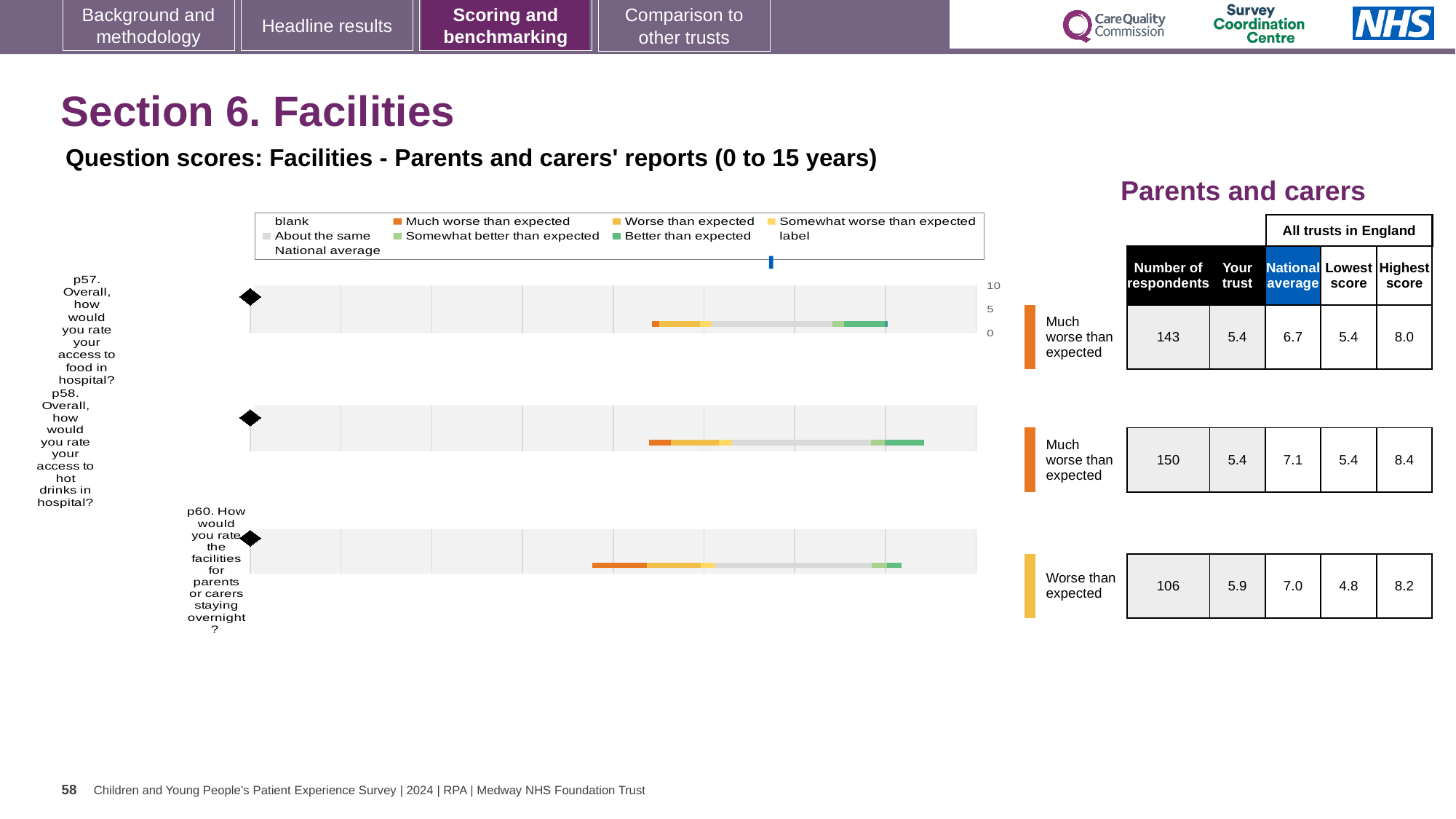
For the p57 chart (access to food in hospital), what is the 'Your trust' score shown in the table? 5.4 For the p58 chart (access to hot drinks in hospital), what is the national average shown in the table? 7.1 Is the 'Your trust' score for p57 (access to food in hospital) larger or smaller than the national average? smaller What is the highest value shown on the axis of the bar charts? 10 What kind of chart is used to show the question scores on this slide? bar chart What is the difference between the national average and the 'Your trust' score for p58 (access to hot drinks in hospital)? 1.7 What benchmark category is assigned to the p60 chart (facilities for parents or carers staying overnight)? Worse than expected Which legend entry is shown in orange in the bar charts' legend? Much worse than expected Which of the three questions has the highest 'Your trust' score in the table: p57, p58 or p60? p60 How many survey questions (p57, p58, p60) are plotted as separate bar charts on the slide? 3 For the p60 chart (facilities for parents or carers staying overnight), how many respondents are shown in the table? 106 For the p60 chart (facilities for parents or carers staying overnight), what is the 'Your trust' score shown in the table? 5.9